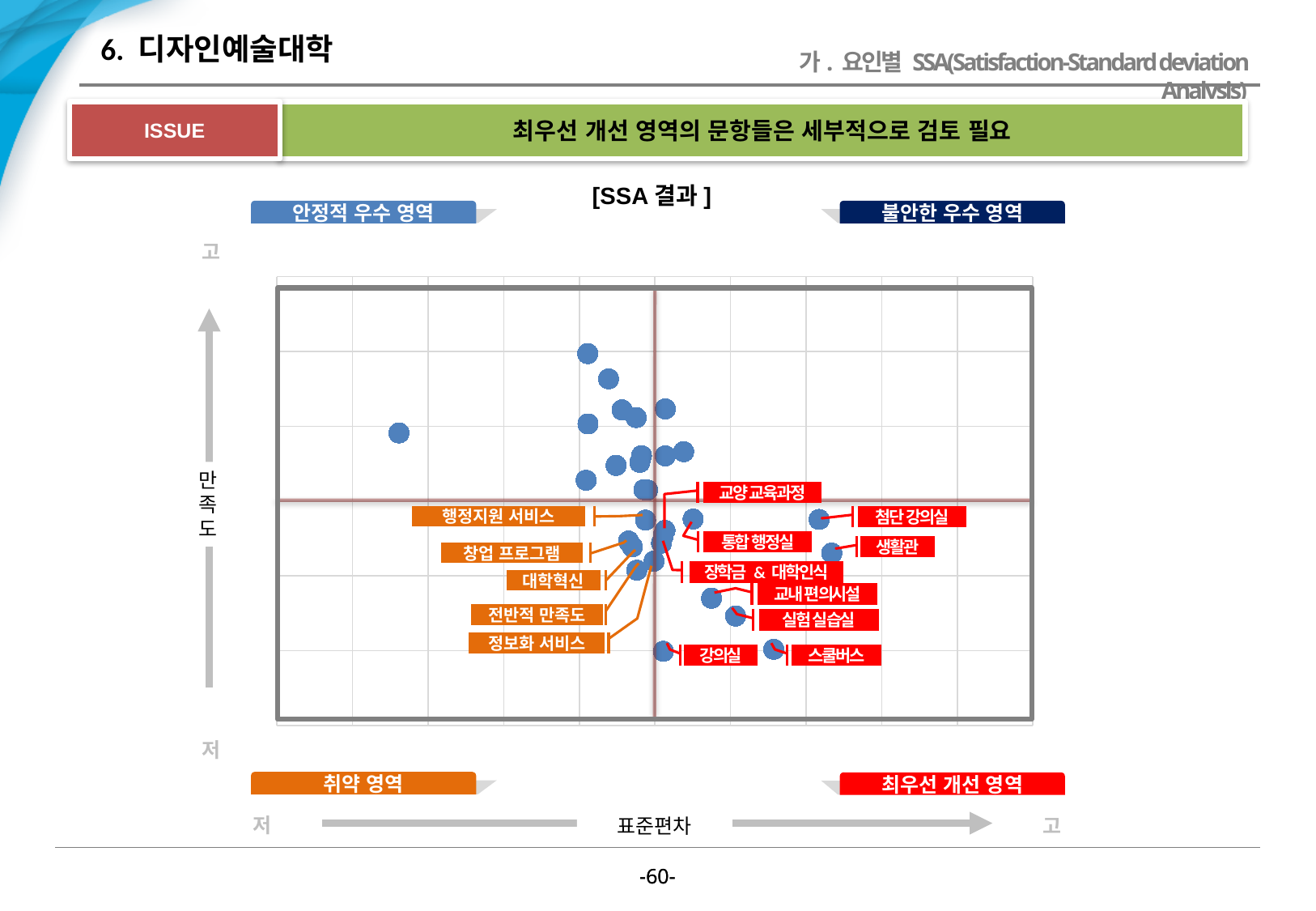
Which has a higher standard deviation (표준편차), 생활관 or 창업 프로그램? 생활관 What is the title of the chart? [SSA 결과 ] Which has higher satisfaction (만족도), 첨단강의실 or 실험실습실? 첨단강의실 Which quadrant label appears at the top left of the chart? 안정적 우수 영역 In which quadrant region does the point labeled 스쿨버스 fall? 최우선 개선 영역 Which quadrant label appears at the bottom right of the chart? 최우선 개선 영역 In which quadrant region does the point labeled 정보화 서비스 fall? 취약 영역 How many labeled points are shown with orange labels on the chart? 5 What is the label of the horizontal axis of the chart? 표준편차 Which has higher satisfaction (만족도), 교양교육과정 or 강의실? 교양교육과정 How many labeled data points are there on the chart? 14 What kind of chart is shown on the slide? Scatter plot